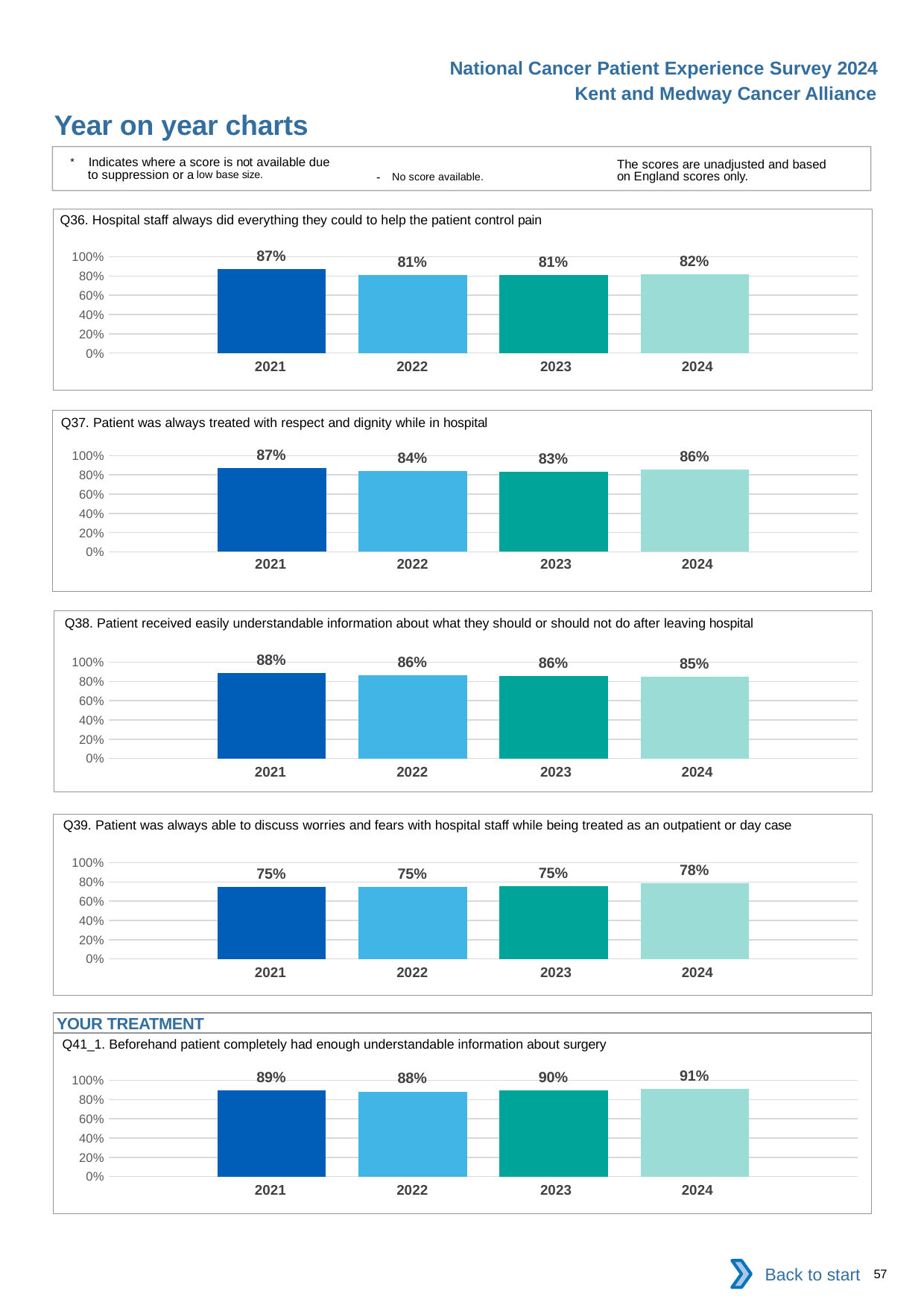
What type of chart is used for Q36? Bar chart In the Q37 chart, what is the difference between the 2021 value and the 2023 value? 4% In the Q36 chart (hospital staff always did everything they could to help the patient control pain), what is the value for 2021? 87% In the Q38 chart, which is larger, the value for 2021 or the value for 2024? 2021 How many years are shown in the Q41_1 chart? 4 In the Q39 chart (patient was always able to discuss worries and fears with hospital staff while being treated as an outpatient or day case), what is the value for 2024? 78% In the Q36 chart, which year has the highest value? 2021 In the Q37 chart (patient was always treated with respect and dignity while in hospital), what is the value for 2024? 86% In the Q41_1 chart (beforehand patient completely had enough understandable information about surgery), which year has the highest value? 2024 In the Q38 chart (patient received easily understandable information about what they should or should not do after leaving hospital), what is the value for 2024? 85% In the Q39 chart, what is the difference between the 2024 value and the 2021 value? 3% In the Q37 chart, which year has the lowest value? 2023